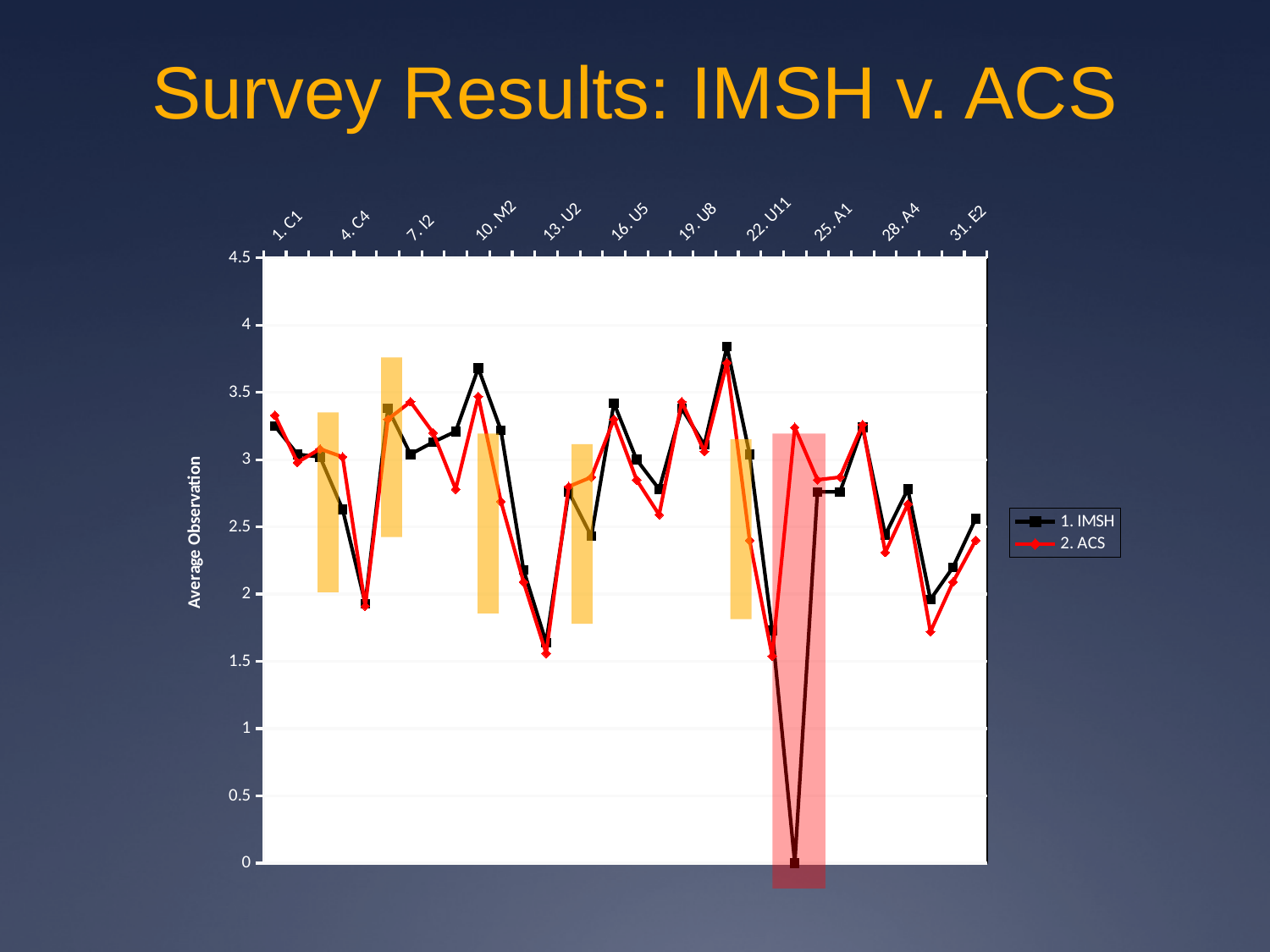
How many series does the legend list? 2 Is the highest value of the 1. IMSH series greater or less than 3.5? greater What are the two series named in the legend? 1. IMSH and 2. ACS How many category labels are printed along the x axis? 11 What kind of chart is shown on the slide? line chart What is the title of the vertical axis? Average Observation Is the value for 2. ACS at 1. C1 greater or less than 3? greater Is the lowest value of the 1. IMSH series greater or less than 0.5? less Which series contains the lowest plotted value on the chart? 1. IMSH